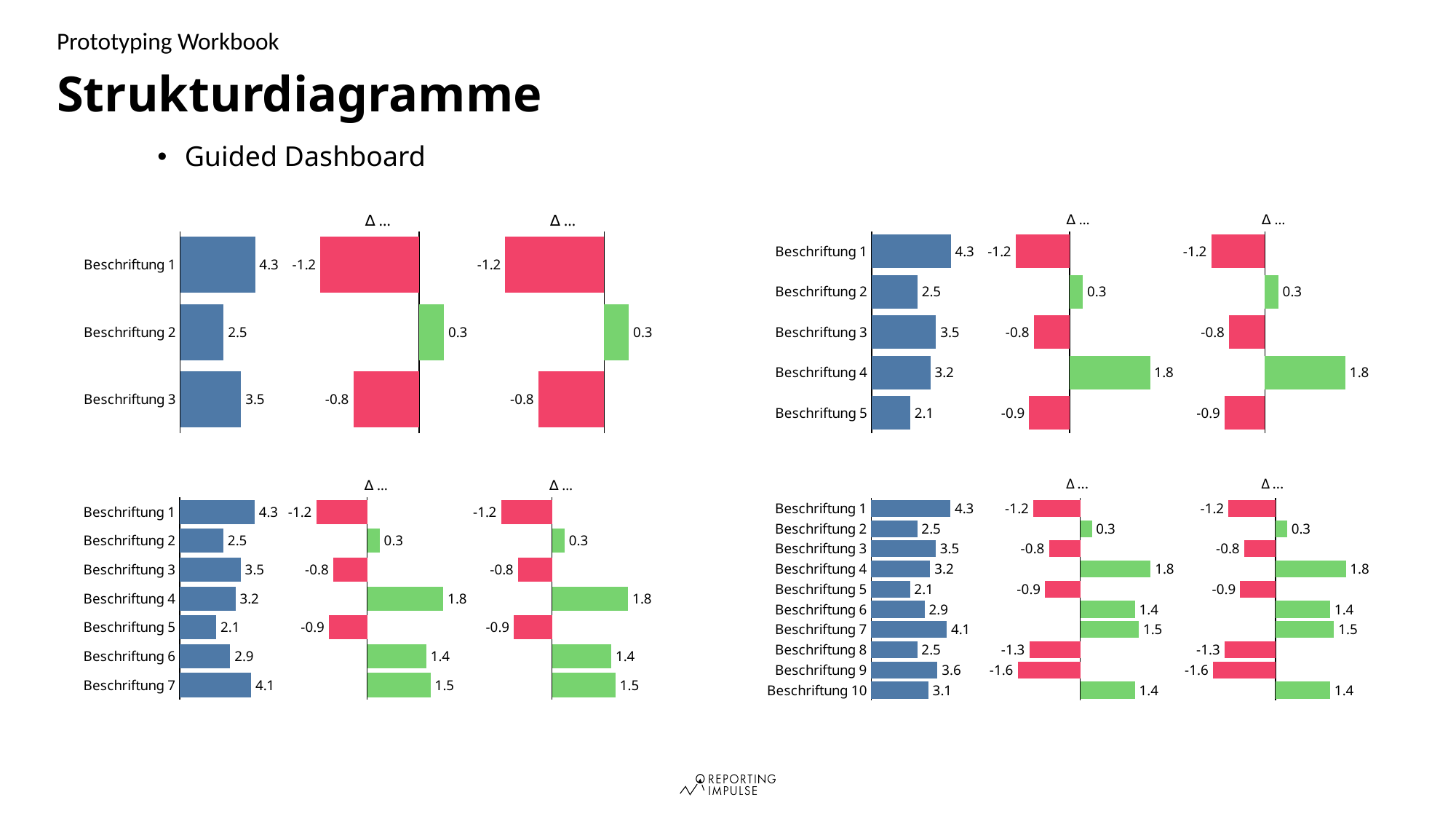
In the top-left chart group, what is the value of the blue bar for Beschriftung 1? 4.3 In the bottom-left chart group, what is the blue bar value for Beschriftung 7? 4.1 In the top-right chart group, what is the delta value shown for Beschriftung 4? 1.8 In the bottom-left chart group, which category has the highest delta value? Beschriftung 4 In the top-right chart group, how many categories are shown? 5 In the bottom-right chart group, how many categories are shown? 10 In the top-right chart group, which category has the lowest blue bar value? Beschriftung 5 In the bottom-left chart group, what is the difference between the blue bar values for Beschriftung 1 and Beschriftung 5? 2.2 In the bottom-right chart group, is the blue bar value for Beschriftung 7 larger or smaller than that for Beschriftung 9? larger What type of chart is used in the top-left chart group? bar chart In the top-left chart group, how many categories are shown? 3 In the bottom-right chart group, what is the delta value for Beschriftung 9? -1.6